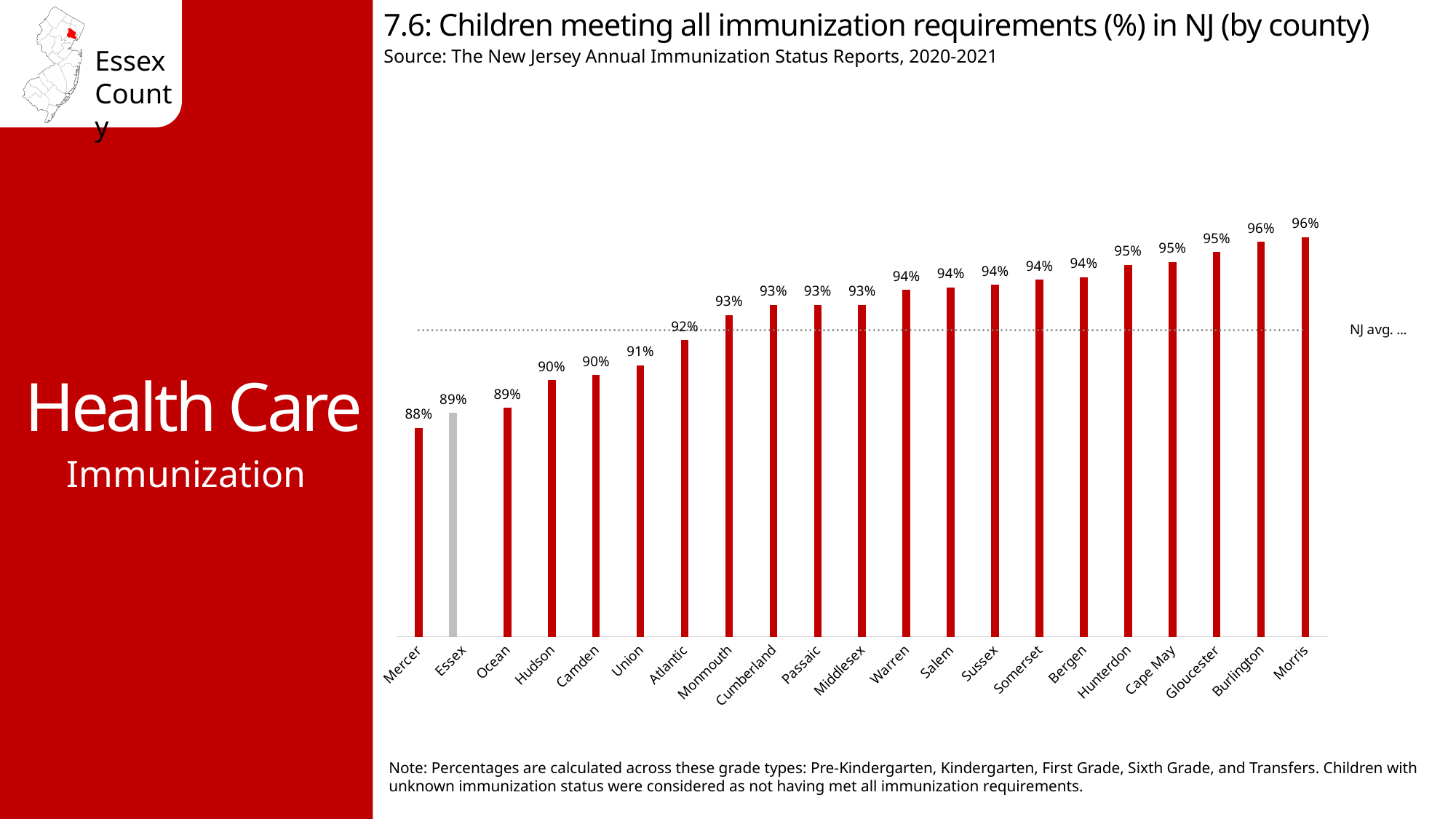
What is the difference in percentage points between Atlantic County and Essex County? 3 percentage points Which county's bar is coloured grey instead of red? Essex What percentage of children in Essex County met all immunization requirements? 89% Which county has the lowest percentage of children meeting all immunization requirements? Mercer Which has a higher value, Hudson or Atlantic? Atlantic What is the value shown for Morris County? 96% What is the value shown for Hunterdon County? 95% What is the value shown for Mercer County? 88% What is the difference in percentage points between Morris County and Mercer County? 8 percentage points How many counties are shown on the chart? 21 Do the values rise or fall moving from left to right along the x axis? Rise What type of chart is used on this slide? Bar chart